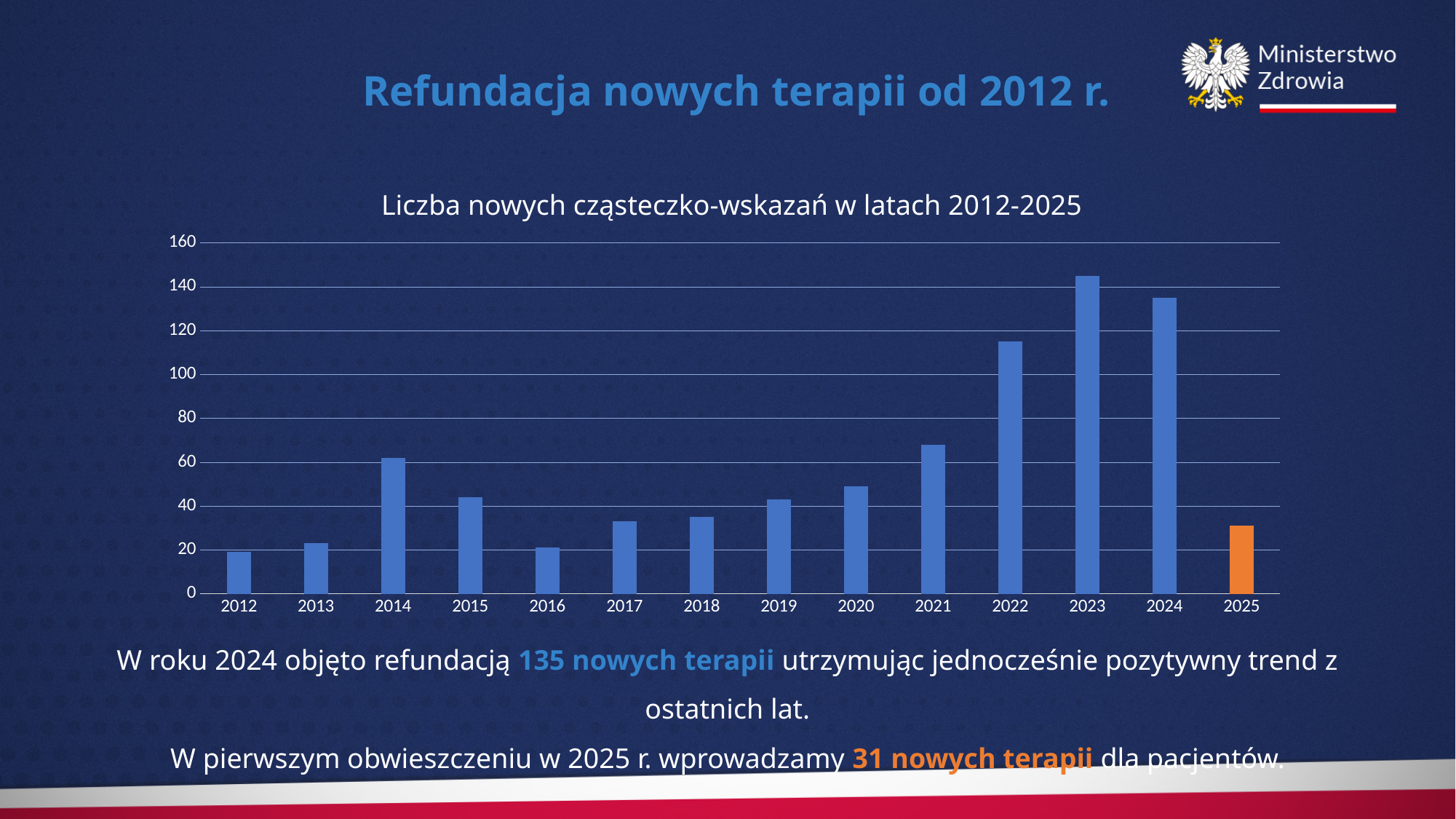
Is the value for 2022 greater or less than 100? greater Which year has the highest bar in the chart? 2023 How many years are shown on the x axis of the chart? 14 Is the value for 2021 greater or less than 80? less According to the slide, how many new therapies were covered by reimbursement in 2024? 135 Do the values rise or fall from 2020 to 2023? rise Is the value for 2016 greater or less than 40? less According to the slide, how many new therapies are introduced in the first announcement of 2025? 31 What is the title of the chart? Liczba nowych cząsteczko-wskazań w latach 2012-2025 What kind of chart is shown on the slide? bar chart Which year has the larger value, 2014 or 2015? 2014 What is the difference between the number of new therapies in 2024 (135) and in 2025 (31)? 104